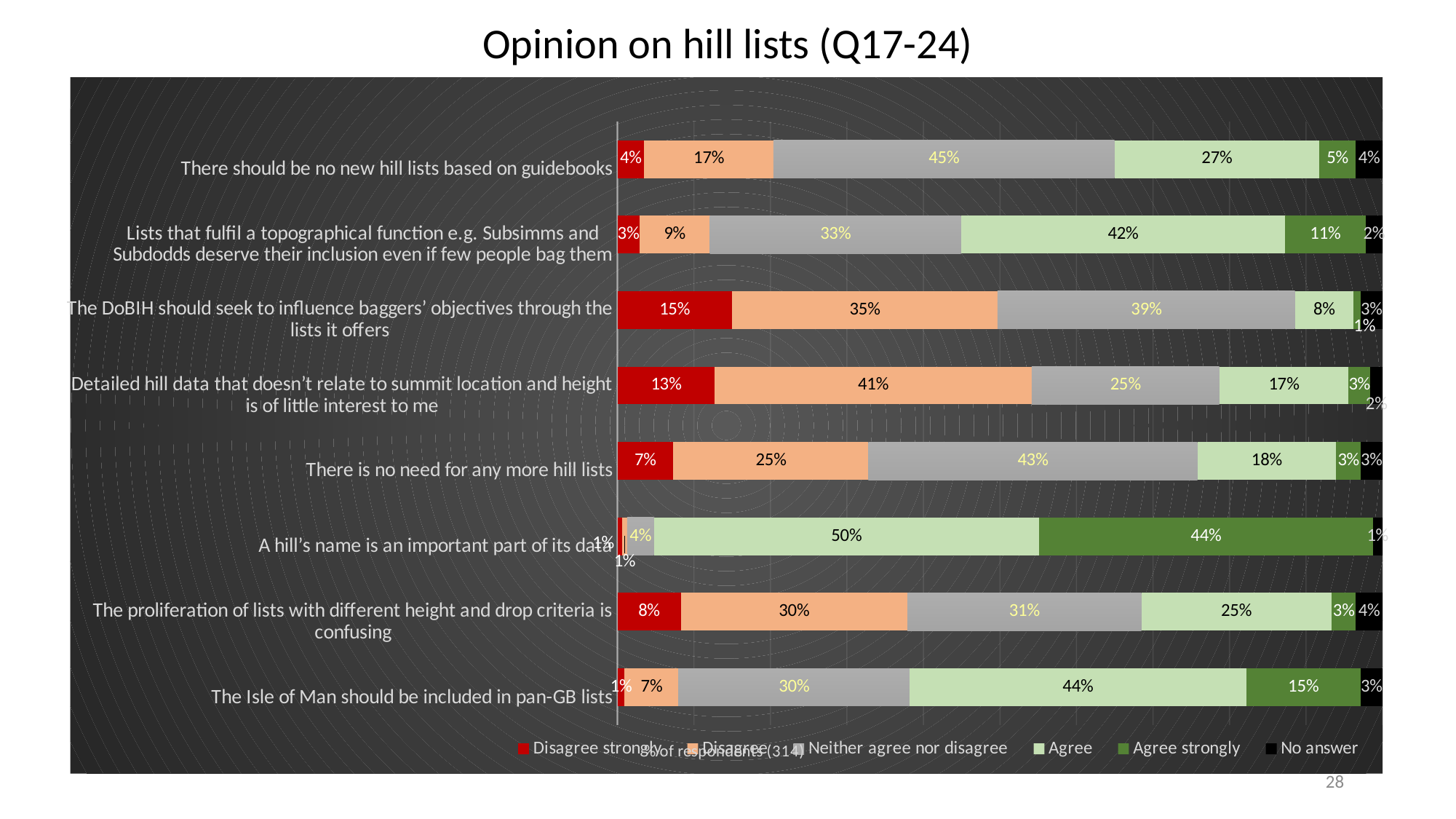
What is the 'Agree' value for 'The Isle of Man should be included in pan-GB lists'? 44% How many statements (categories) are plotted in the chart? 8 What is the 'Agree strongly' value for 'Lists that fulfil a topographical function e.g. Subsimms and Subdodds deserve their inclusion even if few people bag them'? 11% What percentage of respondents chose 'Neither agree nor disagree' for 'There should be no new hill lists based on guidebooks'? 45% What type of chart is shown on the slide? Stacked bar chart Which is larger: the 'Disagree' value for 'The proliferation of lists with different height and drop criteria is confusing' or the 'Disagree' value for 'There is no need for any more hill lists'? The proliferation of lists with different height and drop criteria is confusing What is the difference between the 'Agree' values for 'A hill's name is an important part of its data' and 'There is no need for any more hill lists'? 32% What is the title of the chart? Opinion on hill lists (Q17-24) How many series does the legend list? 6 Which statement has the highest 'Disagree strongly' percentage? The DoBIH should seek to influence baggers' objectives through the lists it offers What is the 'Disagree' value for 'Detailed hill data that doesn't relate to summit location and height is of little interest to me'? 41% Which statement has the highest 'Agree strongly' percentage? A hill's name is an important part of its data